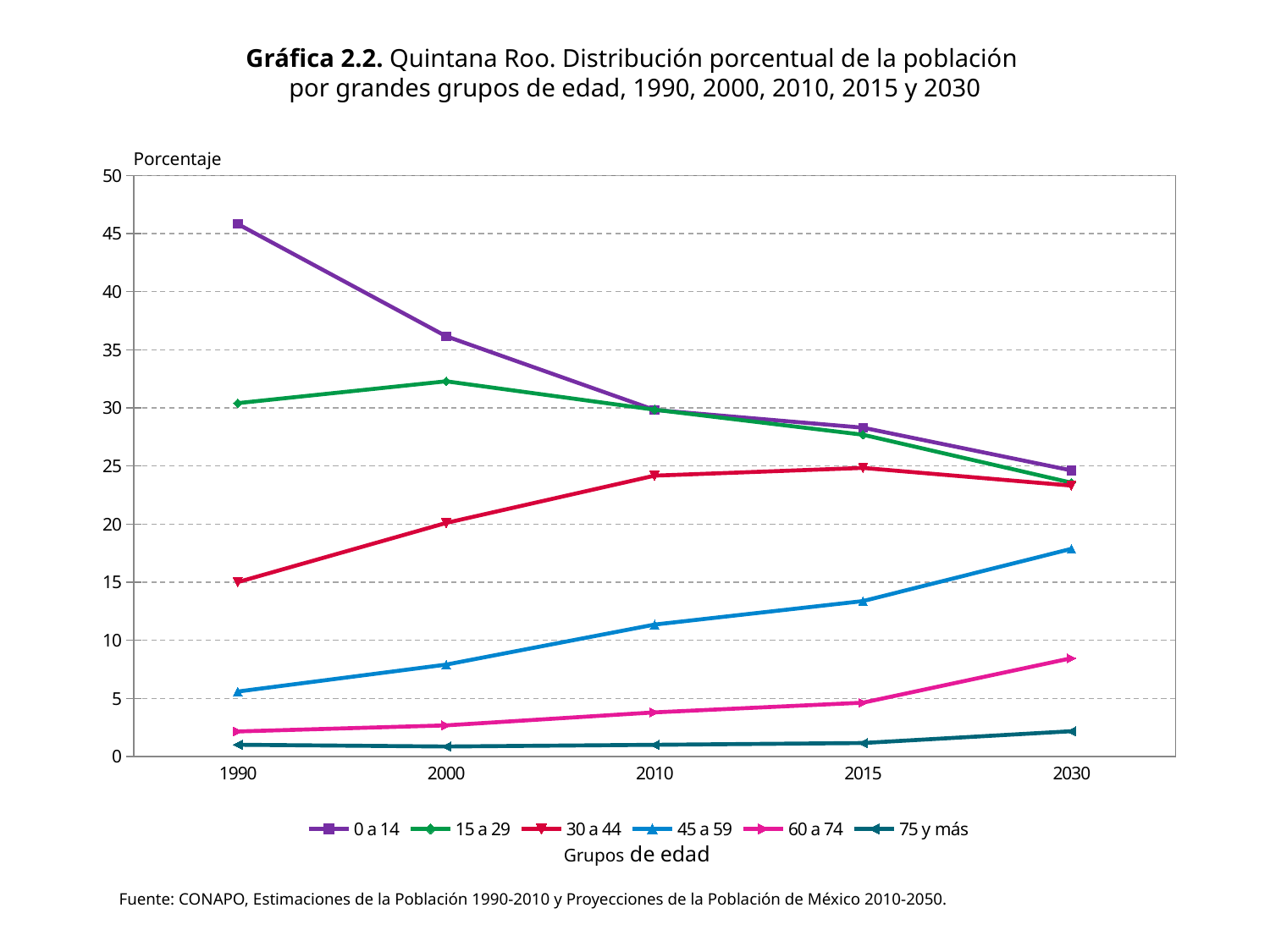
What kind of chart is shown on the slide? line chart Does the value for the '45 a 59' series rise or fall from 1990 to 2030? rise Which age group has the highest value in 1990? 0 a 14 Is the value for '0 a 14' in 1990 greater or less than 40? greater How many years are plotted along the x axis? 5 In 2030, which is larger: the value for '15 a 29' or the value for '45 a 59'? 15 a 29 Which age group has the lowest value in 1990? 75 y más Is the value for '60 a 74' in 2030 greater or less than 5? greater Is the value for '30 a 44' in 2000 greater or less than 25? less Does the value for the '0 a 14' series rise or fall from 1990 to 2030? fall How many series does the legend list? 6 What is the label on the vertical axis of the chart? Porcentaje